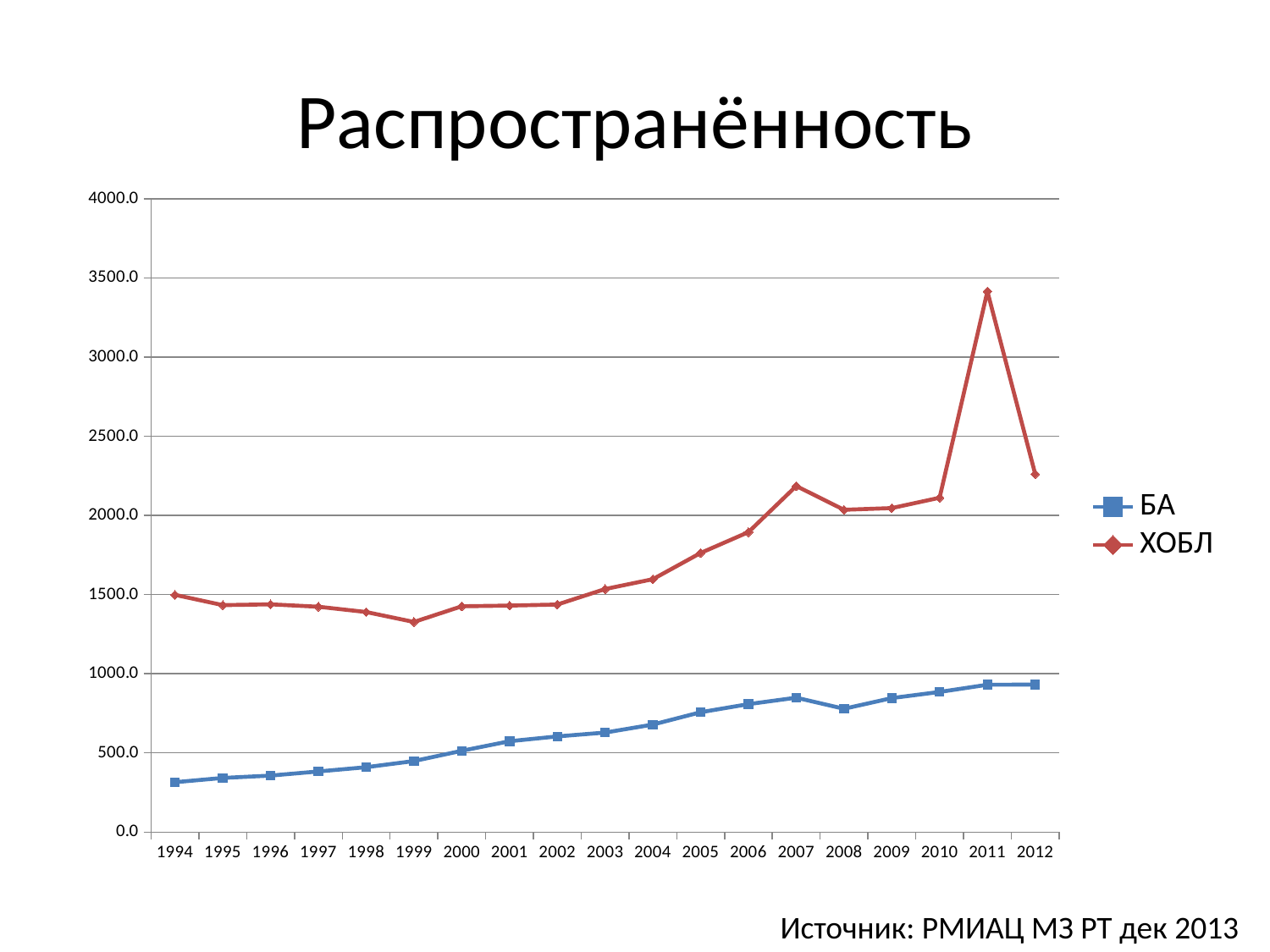
What kind of chart is shown on the slide? line chart In which year does the ХОБЛ series reach its highest value? 2011 Is the value for БА in 2012 greater or less than 1000? less What is the title of the chart? Распространённость In which year does the БА series have its lowest value? 1994 How many years are shown on the x axis? 19 Which series has the higher value in 2007, БА or ХОБЛ? ХОБЛ What are the two series named in the legend? БА and ХОБЛ Is the value for БА in 1994 greater or less than 500? less In which year does the ХОБЛ series reach its lowest value? 1999 Is the value for ХОБЛ in 2011 greater or less than 3000? greater How many series does the legend list? 2